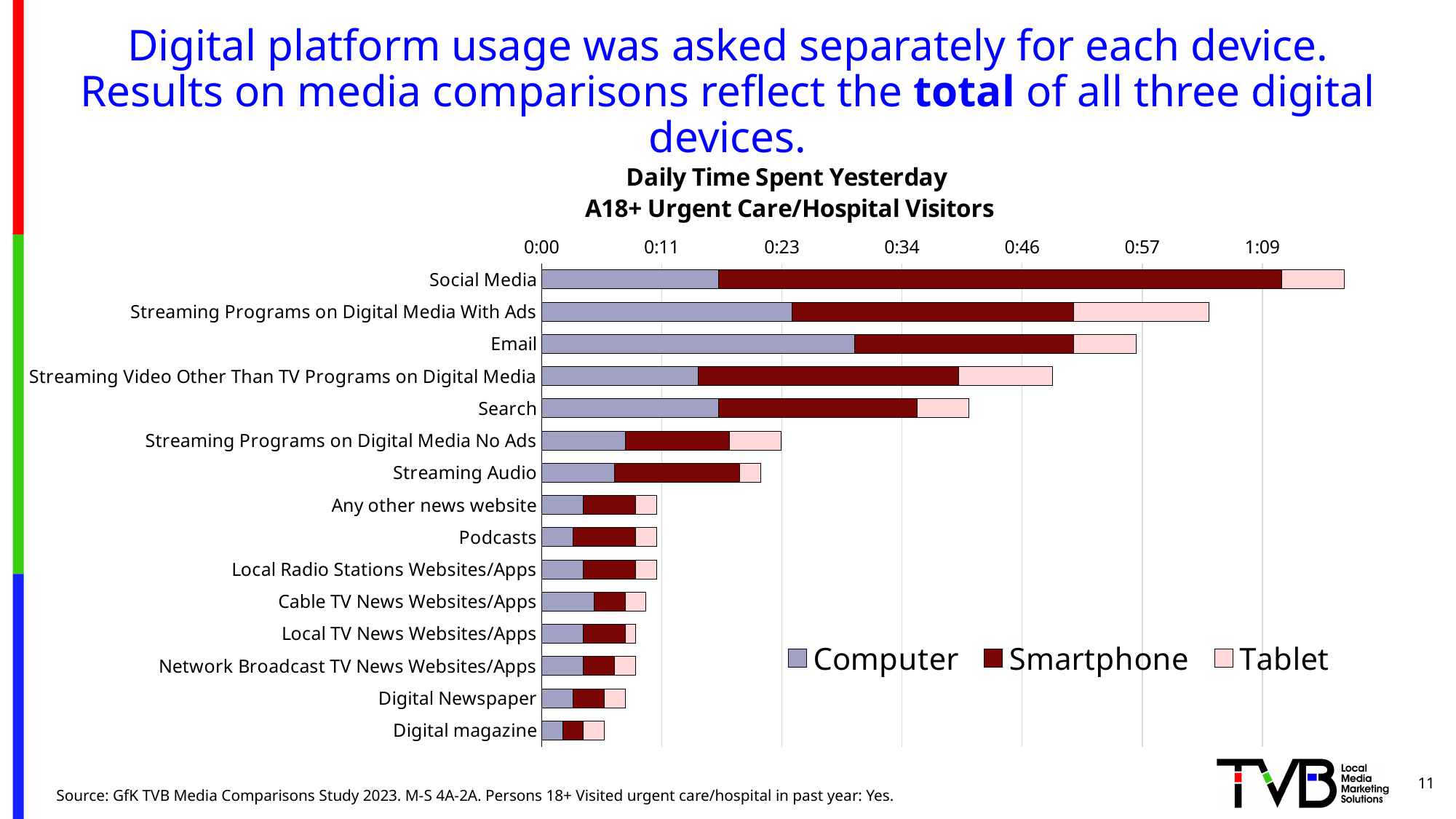
Is the total value for Digital magazine greater or less than 0:11? less Which has a larger Computer segment, Email or Social Media? Email Is the total value for Social Media greater or less than 1:09? greater Which series is shown in the darkest red colour in the legend? Smartphone What kind of chart is shown on the slide? Stacked bar chart Which category has the lowest total daily time spent? Digital magazine Is the total value for Streaming Programs on Digital Media With Ads greater or less than 0:57? greater Which category has the highest total daily time spent? Social Media How many series does the legend list? 3 How many categories are plotted on the chart? 15 What is the title of the chart? Daily Time Spent Yesterday A18+ Urgent Care/Hospital Visitors